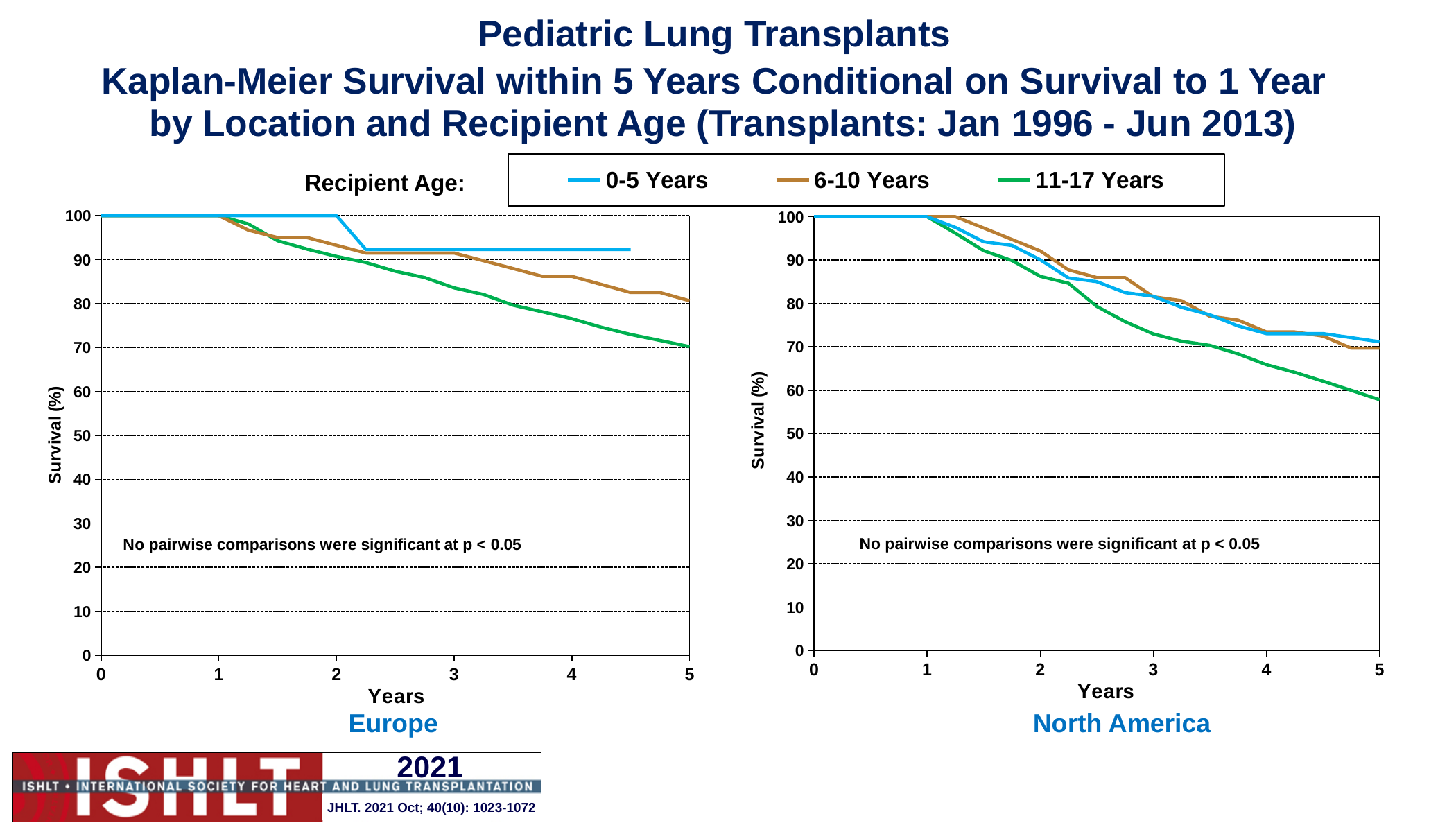
What kind of chart is the Europe chart? line chart In the Europe chart, at 5 years, which is higher: 6-10 Years or 11-17 Years? 6-10 Years In the Europe chart, is the survival for 11-17 Years at 3 years greater or less than 80? greater What is the label of the y axis on the Europe chart? Survival (%) In the Europe chart, is the survival for 0-5 Years at 4 years greater or less than 90? greater In the North America chart, is the survival for 11-17 Years at 4 years greater or less than 70? less In the Europe chart, which series has the lowest survival at 5 years? 11-17 Years In the North America chart, which series has the lowest survival at 5 years? 11-17 Years In the North America chart, at 5 years, which is higher: 0-5 Years or 11-17 Years? 0-5 Years How many series does the legend list? 3 In the North America chart, does survival for 11-17 Years rise or fall as years increase? fall